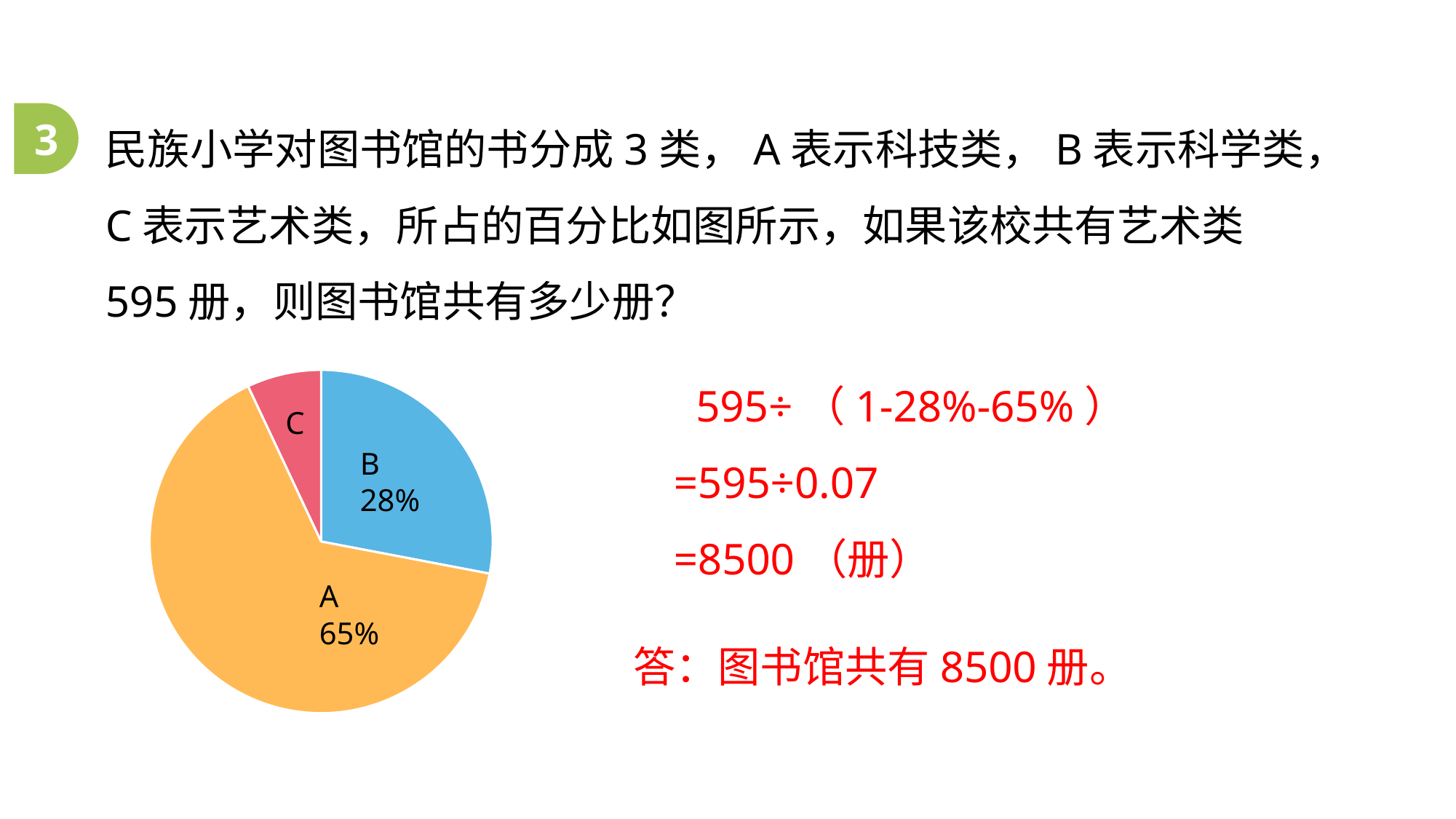
What colour is slice B in the pie chart? blue What percentage does slice B represent in the pie chart? 28% What percentage does slice A represent in the pie chart? 65% What kind of chart is shown on the slide? pie chart Which is larger in the pie chart, slice B or slice C? B What colour is slice A in the pie chart? orange What is the difference in percentage points between slice A and slice B? 37% Which slice of the pie chart is the smallest? C Which is larger in the pie chart, slice A or slice B? A How many slices does the pie chart have? 3 What share of the pie does slice C represent, given the printed values for A and B? 7% Which slice of the pie chart is the largest? A